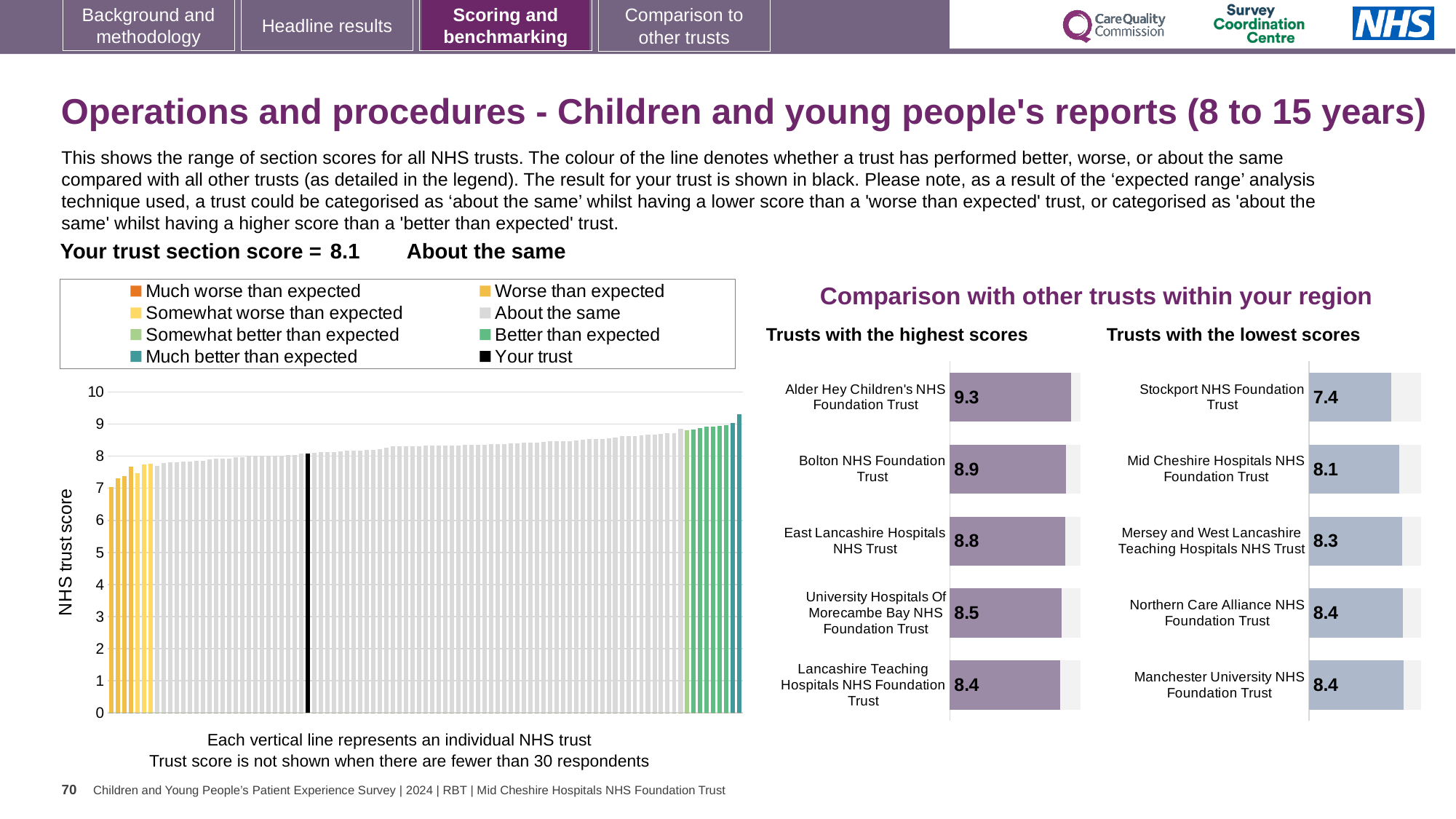
In the large chart on the left showing all NHS trusts, is the value of the tallest bar greater or less than 9? greater In the 'Trusts with the lowest scores' chart, which trust has the lowest score? Stockport NHS Foundation Trust In the 'Trusts with the lowest scores' chart, what is the score for Mersey and West Lancashire Teaching Hospitals NHS Trust? 8.3 How many trusts are shown in the 'Trusts with the highest scores' chart? 5 In the 'Trusts with the highest scores' chart, what is the score for University Hospitals Of Morecambe Bay NHS Foundation Trust? 8.5 Which has the higher score: Bolton NHS Foundation Trust in the 'highest scores' chart or Mersey and West Lancashire Teaching Hospitals NHS Trust in the 'lowest scores' chart? Bolton NHS Foundation Trust In the 'Trusts with the highest scores' chart, what is the score for Alder Hey Children's NHS Foundation Trust? 9.3 In the 'Trusts with the highest scores' chart, which trust has the highest score? Alder Hey Children's NHS Foundation Trust In the 'Trusts with the lowest scores' chart, what is the difference between the scores of Mid Cheshire Hospitals NHS Foundation Trust and Stockport NHS Foundation Trust? 0.7 In the 'Trusts with the highest scores' chart, what is the difference between the scores of Alder Hey Children's NHS Foundation Trust and Lancashire Teaching Hospitals NHS Foundation Trust? 0.9 In the 'Trusts with the lowest scores' chart, what is the score for Stockport NHS Foundation Trust? 7.4 What kind of chart is the large chart on the left showing all NHS trusts? Bar chart